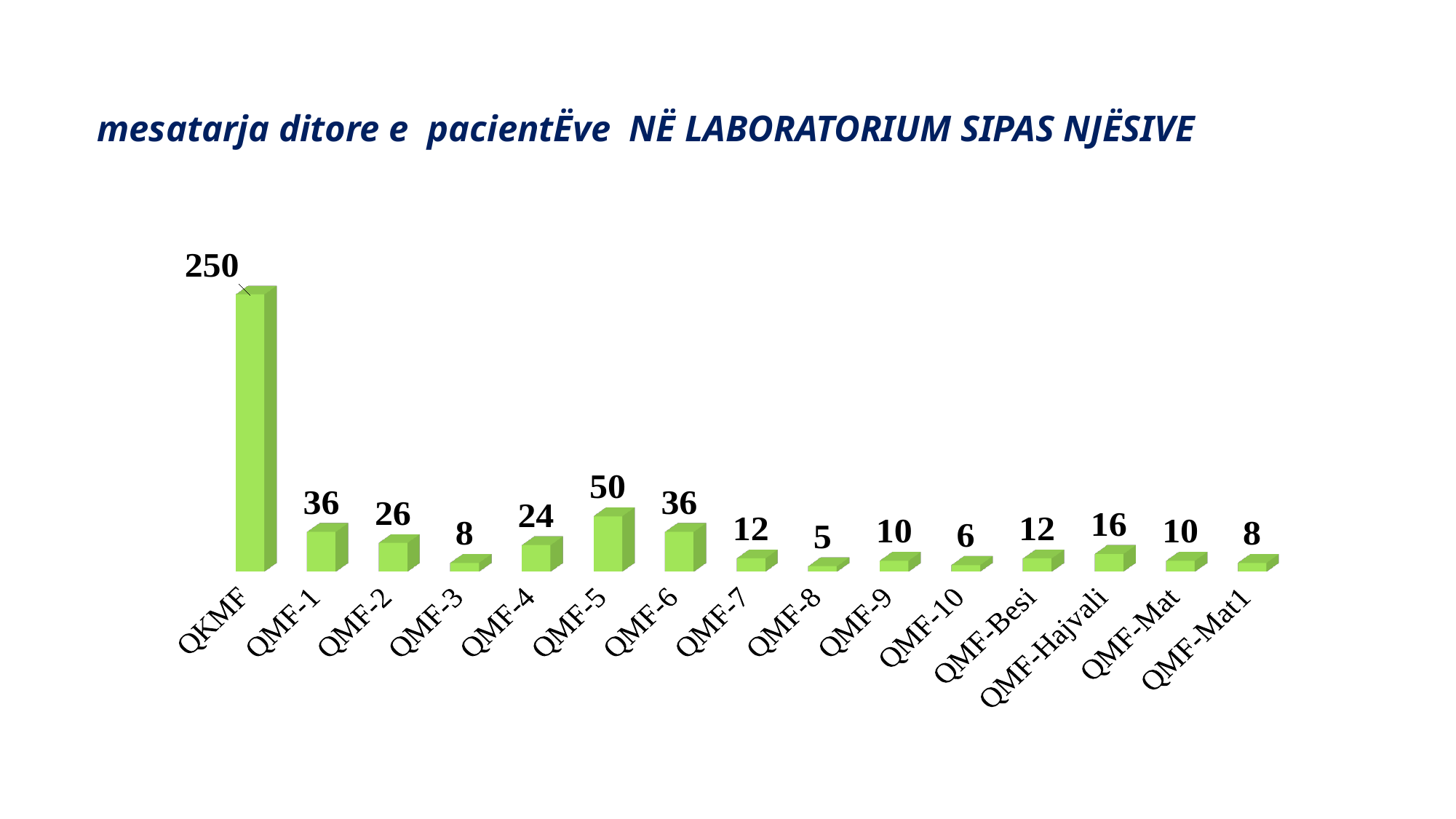
What is the difference between the values for QMF-2 and QMF-3? 18 What is the value for QMF-Hajvali? 16 What kind of chart is shown on the slide? Bar chart What is the title of the chart? mesatarja ditore e pacientËve NË LABORATORIUM SIPAS NJËSIVE What is the value for QKMF? 250 What is the difference between the values for QKMF and QMF-5? 200 What is the value for QMF-8? 5 Which is larger, the value for QMF-4 or the value for QMF-Besi? QMF-4 How many categories are shown on the x axis? 15 What is the value for QMF-5? 50 Which category has the lowest value? QMF-8 Which category has the highest value? QKMF